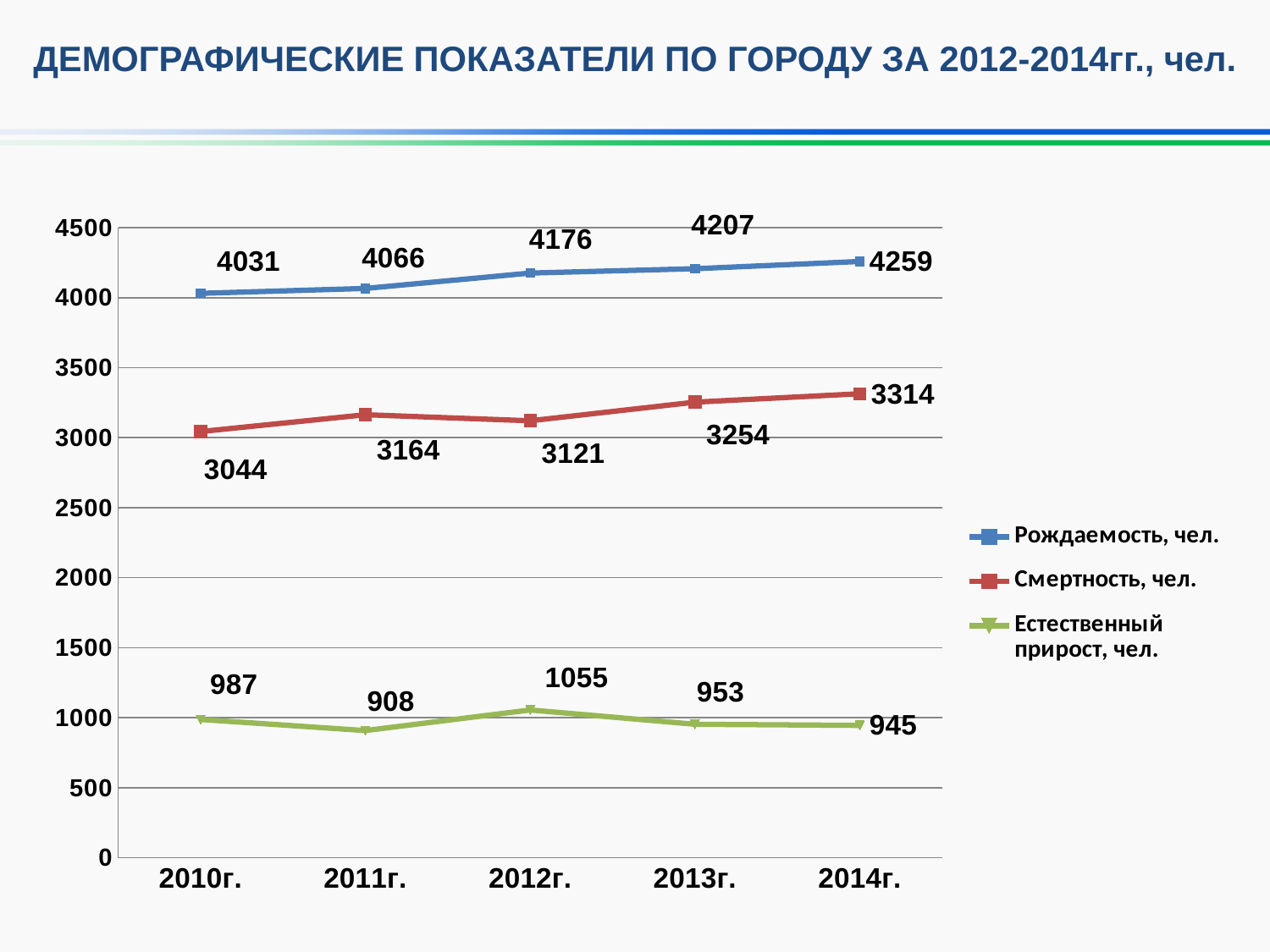
Which is larger: Смертность, чел. in 2011г. or in 2012г.? 2011г. Is the value of Рождаемость, чел. in 2013г. greater or less than 4000? greater Does Рождаемость, чел. rise or fall from 2010г. to 2014г.? rise How many series does the legend list? 3 What is the value of Рождаемость, чел. in 2012г.? 4176 What kind of chart is shown on the slide? line chart What is the difference between Рождаемость, чел. in 2014г. and in 2010г.? 228 In which year is Смертность, чел. lowest? 2010г. What is the value of Естественный прирост, чел. in 2014г.? 945 In which year is Естественный прирост, чел. highest? 2012г. How many years are shown on the x axis? 5 What is the value of Смертность, чел. in 2010г.? 3044